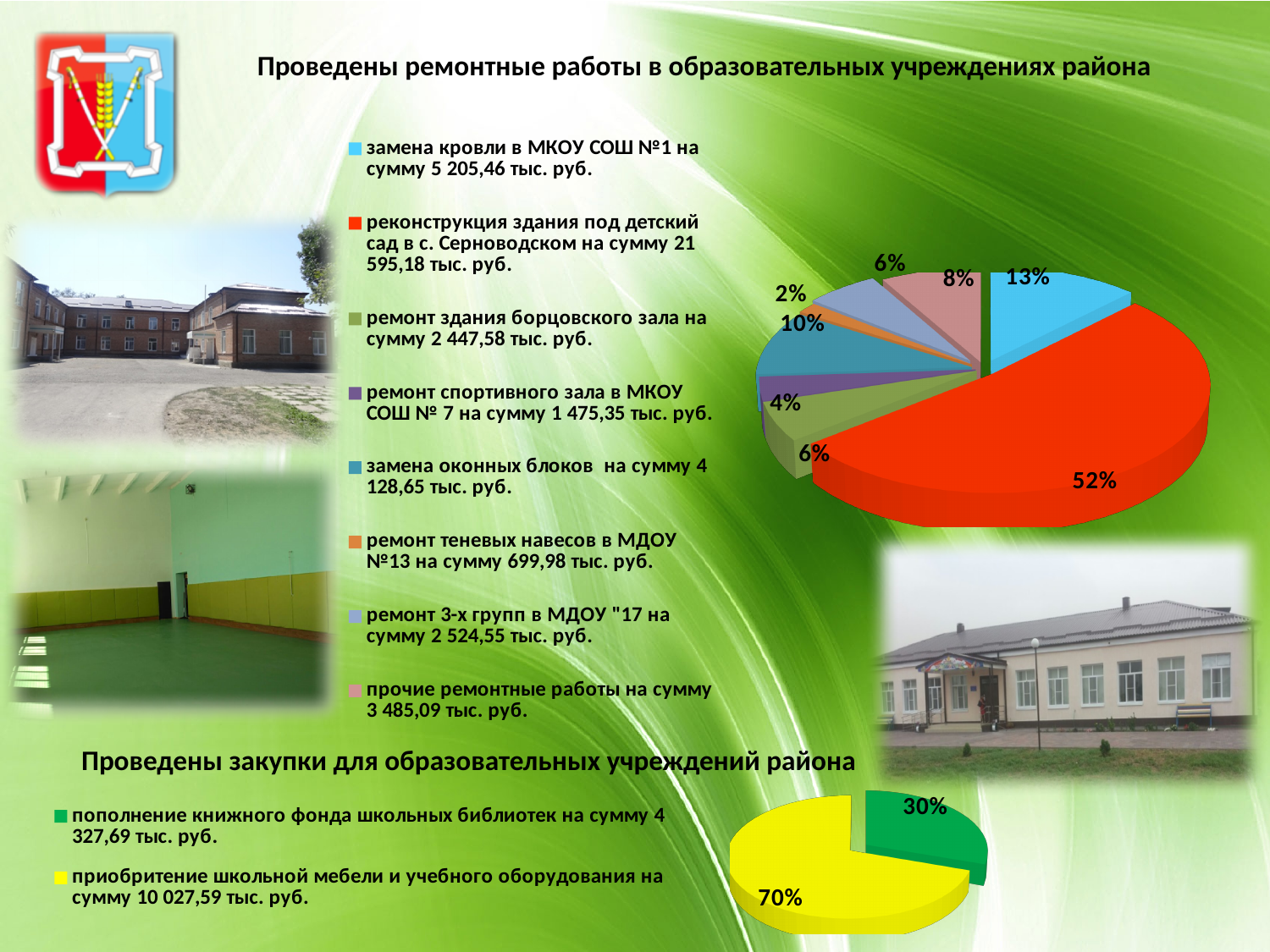
In the bottom pie chart, what share is shown for пополнение книжного фонда школьных библиотек? 30% In the top pie chart, which is larger: the slice for замена оконных блоков or the slice for ремонт спортивного зала в МКОУ СОШ № 7? замена оконных блоков In the top pie chart, how many categories does the legend list? 8 In the bottom pie chart (Проведены закупки для образовательных учреждений района), what share is shown for приобритение школьной мебели и учебного оборудования? 70% In the top pie chart, what is the difference in percentage points between the slice for реконструкция здания под детский сад (52%) and the slice for замена кровли в МКОУ СОШ №1 (13%)? 39 percentage points In the top pie chart, which category has the largest slice? реконструкция здания под детский сад в с. Серноводском In the top pie chart, which category has the smallest slice? ремонт теневых навесов в МДОУ №13 In the top pie chart (Проведены ремонтные работы в образовательных учреждениях района), what share is shown for реконструкция здания под детский сад в с. Серноводском? 52% In the top pie chart, what share is shown for замена кровли в МКОУ СОШ №1? 13% What type of chart is the bottom chart on the slide? Pie chart In the bottom pie chart, what colour is the slice for пополнение книжного фонда школьных библиотек? Green In the top pie chart, what share is shown for замена оконных блоков? 10%